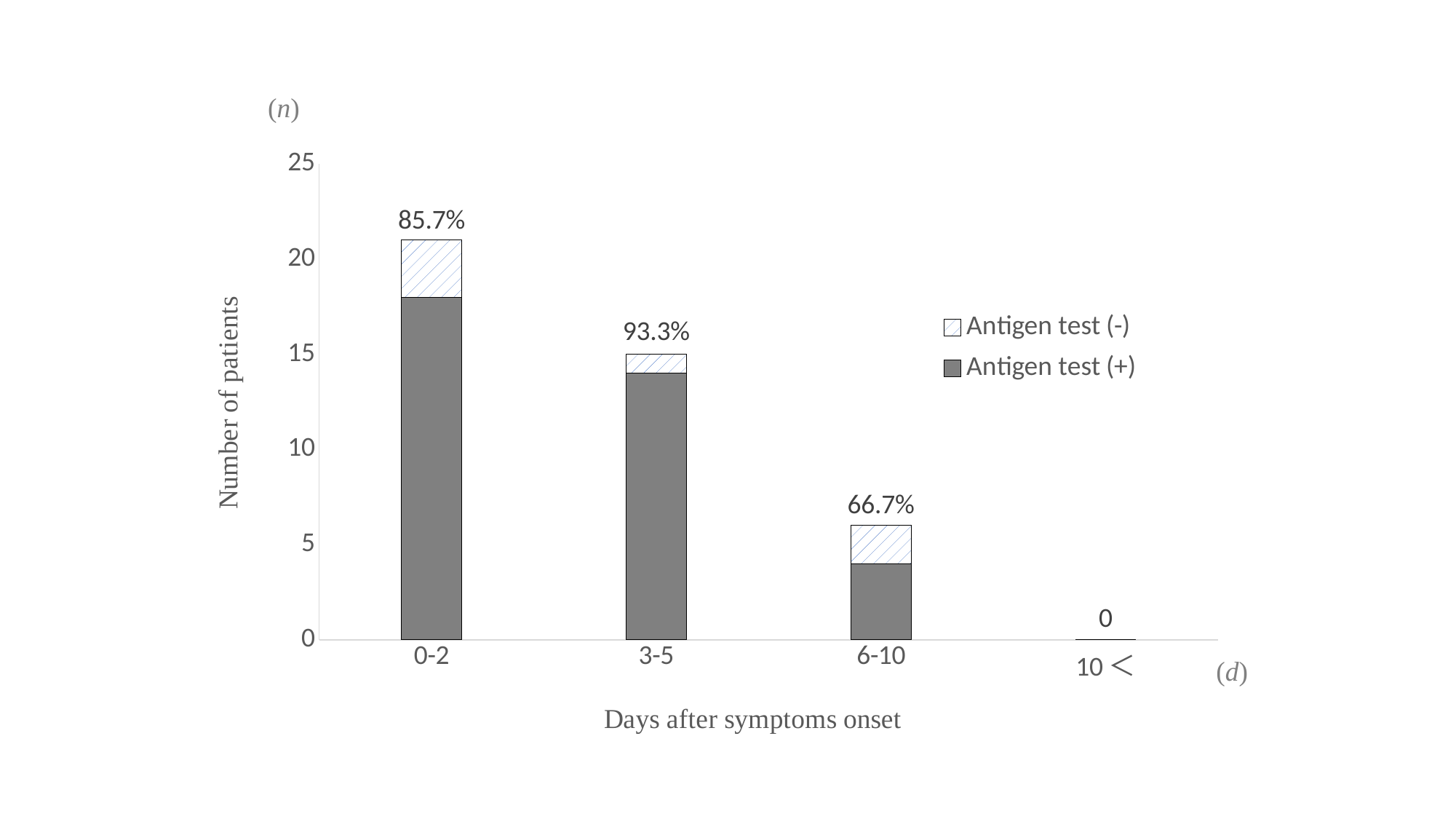
What percentage label is shown above the 6-10 days bar? 66.7% Which category has the highest percentage label? 3-5 How many series does the legend list? 2 How many categories are shown on the x axis? 4 What kind of chart is shown on the slide? bar chart Is the total number of patients for the 6-10 days category greater or less than 10? less What percentage label is shown above the 0-2 days bar? 85.7% Is the total number of patients for the 0-2 days category greater or less than 20? greater What percentage label is shown above the 3-5 days bar? 93.3% Which category has the tallest stacked bar (most patients)? 0-2 What value is labelled for the 10< days category? 0 What is the difference between the percentage labels for 3-5 days and 0-2 days? 7.6%